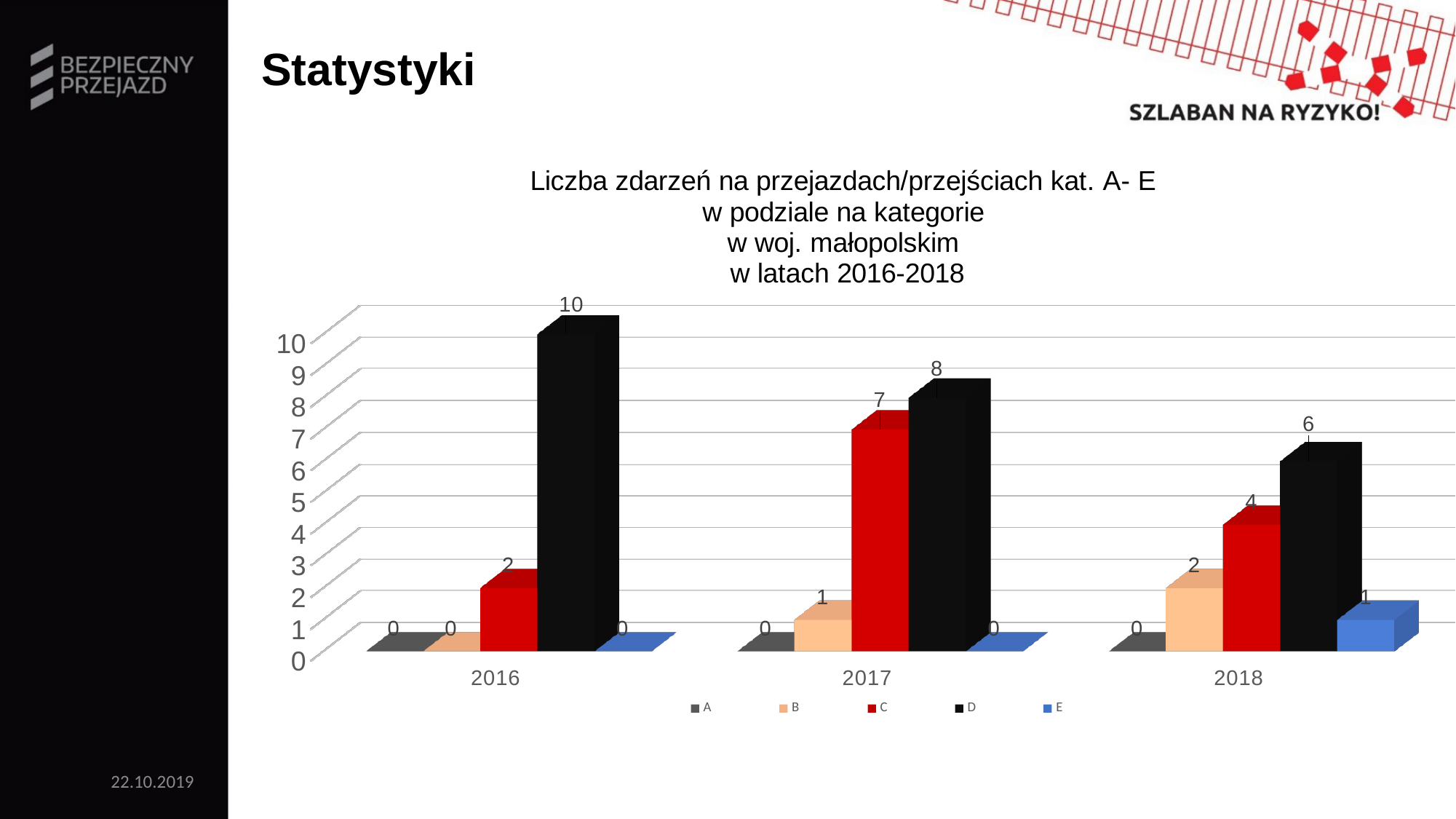
What is the value for series B in 2018? 2 Which year has the highest value for series D? 2016 What is the difference between the values for series D and series C in 2017? 1 What is the value for series C in 2017? 7 What is the value for series E in 2018? 1 Which year has the lowest value for series C? 2016 How many series does the legend list? 5 What kind of chart is shown on the slide? Bar chart Which is larger in 2018: the value for series C or the value for series D? D What is the value for series D in 2016? 10 How many years are shown on the x axis? 3 Do the values for series D rise or fall from 2016 to 2018? Fall